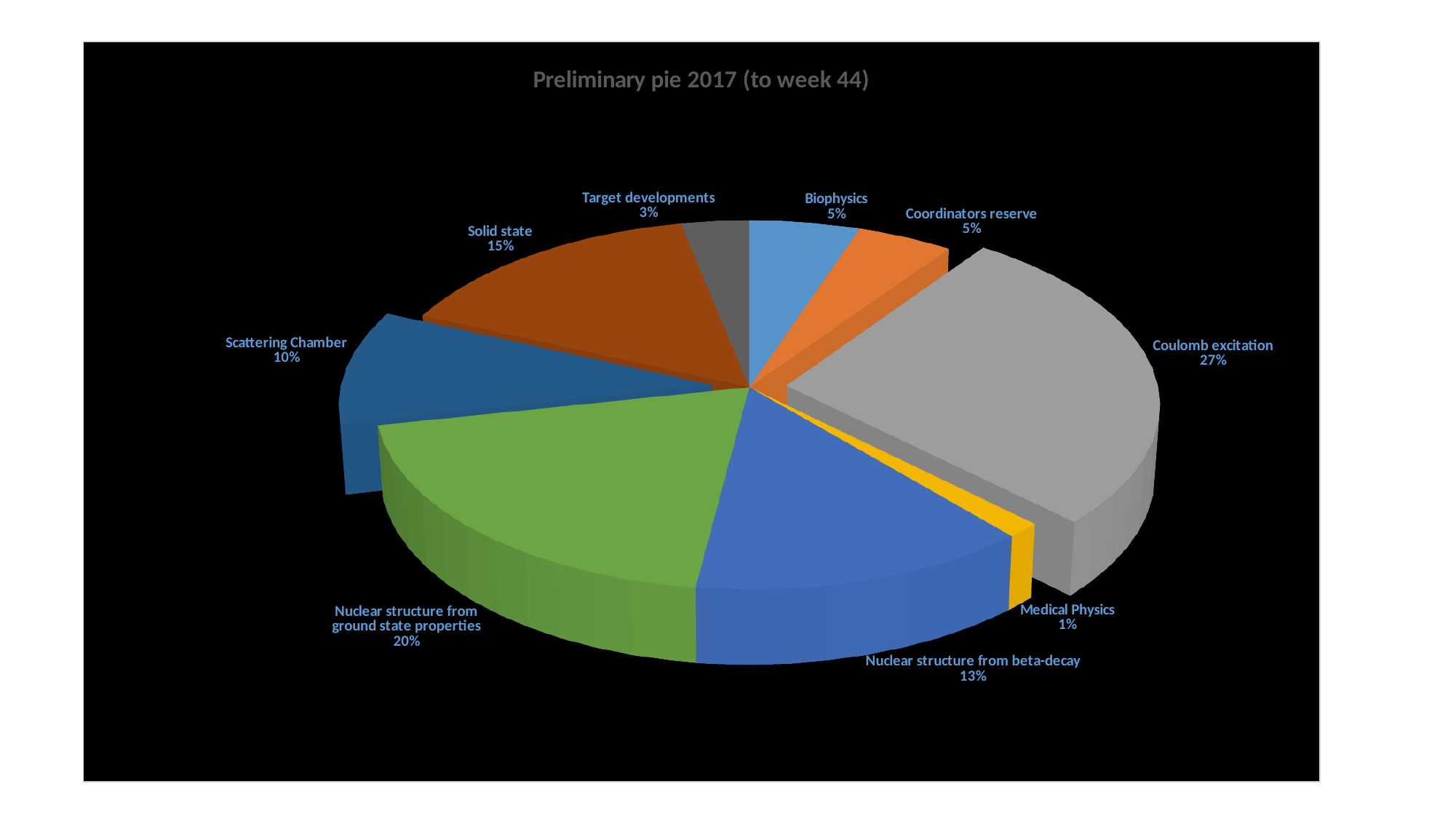
What percentage is shown for Scattering Chamber? 10% What kind of chart is shown on the slide? Pie chart How many categories are shown in the pie chart? 9 Which category has the largest slice of the pie? Coulomb excitation What is the title of the chart? Preliminary pie 2017 (to week 44) What percentage is shown for Target developments? 3% Which is larger, Solid state or Scattering Chamber? Solid state Which category has the smallest slice of the pie? Medical Physics What is the value shown for Nuclear structure from ground state properties? 20% What is the difference in percentage points between Solid state and Nuclear structure from beta-decay? 2 What share of the pie does Coulomb excitation have? 27% What is the combined share of Biophysics and Coordinators reserve? 10%